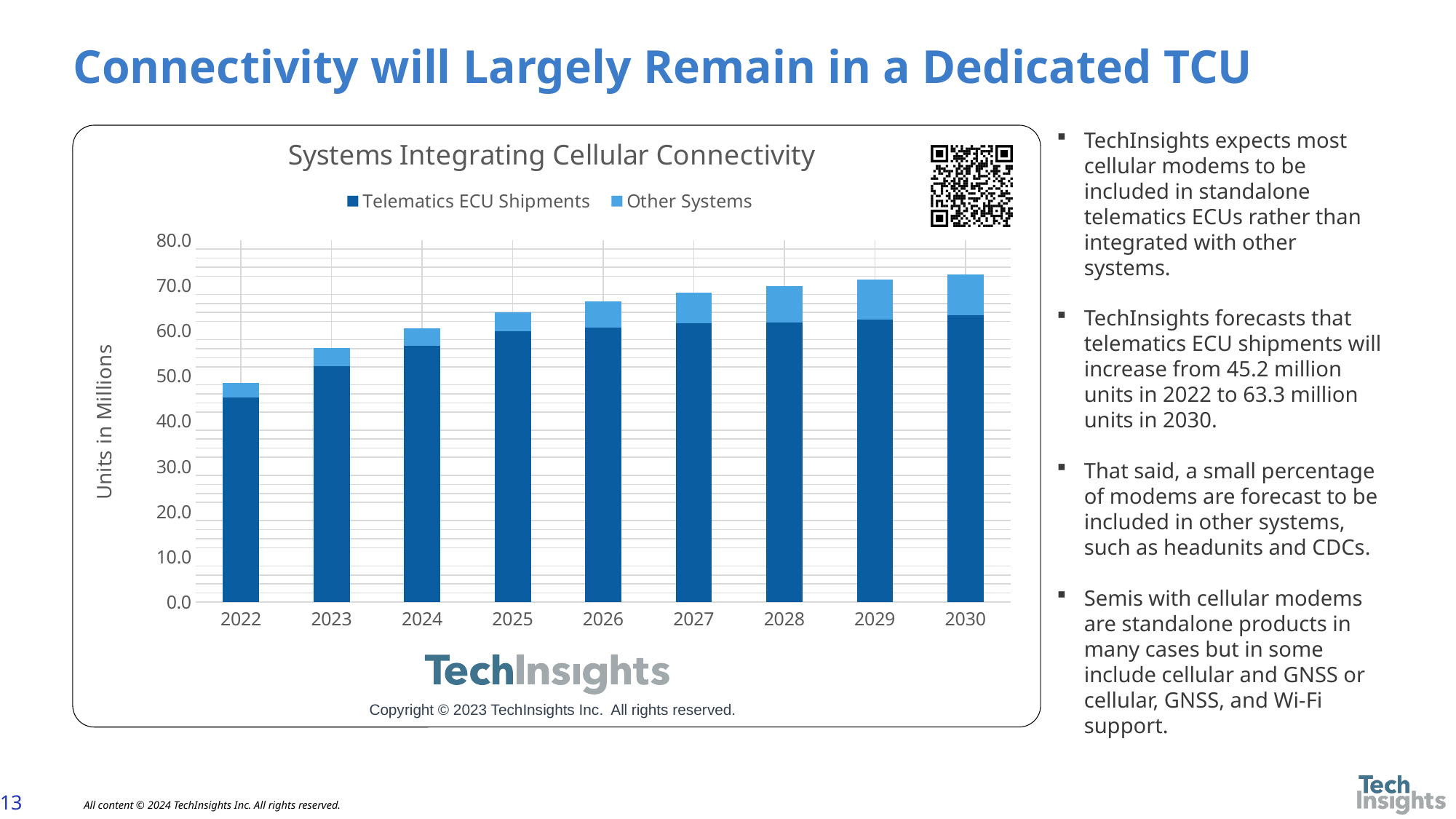
What is the label on the y axis of the chart? Units in Millions Is the Telematics ECU Shipments value for 2030 greater or less than 60.0? greater Which year has the highest total bar in the chart? 2030 Is the Telematics ECU Shipments value for 2022 greater or less than 50.0? less How many years are shown on the x axis of the chart? 9 What is the title of the chart? Systems Integrating Cellular Connectivity How many series does the chart legend list? 2 Is the total bar height for 2030 greater or less than 70.0? greater Do the total bar heights rise or fall from 2022 to 2030? Rise Which year has the lowest total bar in the chart? 2022 What kind of chart is shown on the slide? Stacked bar chart